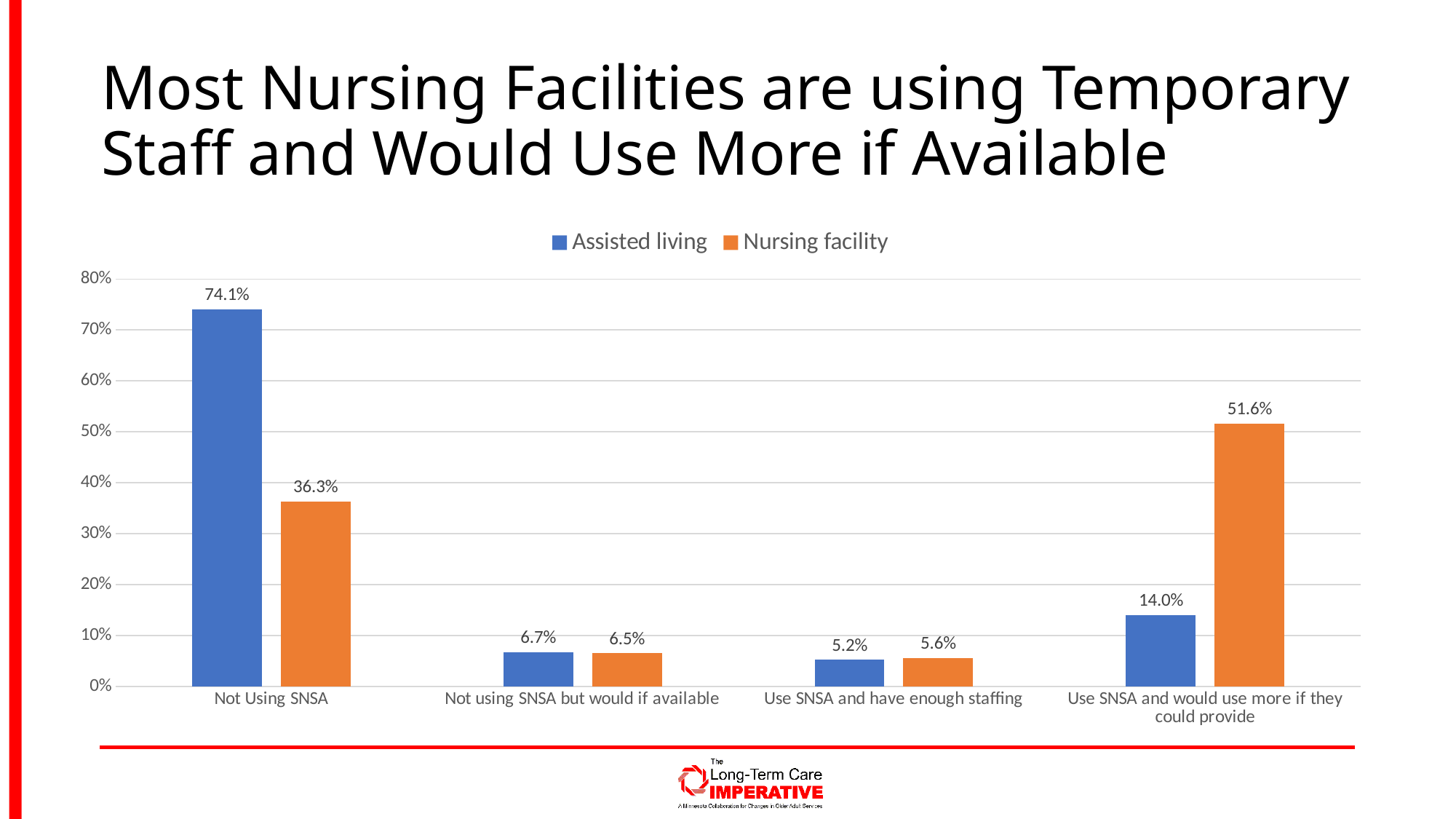
Is the Nursing facility value for "Not Using SNSA" greater or less than 40%? less How many categories are shown on the x axis? 4 What is the Nursing facility value for "Not Using SNSA"? 36.3% For "Use SNSA and would use more if they could provide", which series has the larger value, Assisted living or Nursing facility? Nursing facility What is the Assisted living value for "Use SNSA and have enough staffing"? 5.2% What is the Nursing facility value for "Use SNSA and would use more if they could provide"? 51.6% What kind of chart is shown on the slide? Bar chart Which category has the highest Nursing facility value? Use SNSA and would use more if they could provide What is the Assisted living value for "Not Using SNSA"? 74.1% How many series does the legend list? 2 Which category has the lowest Assisted living value? Use SNSA and have enough staffing What is the difference between the Assisted living and Nursing facility values for "Not Using SNSA"? 37.8%